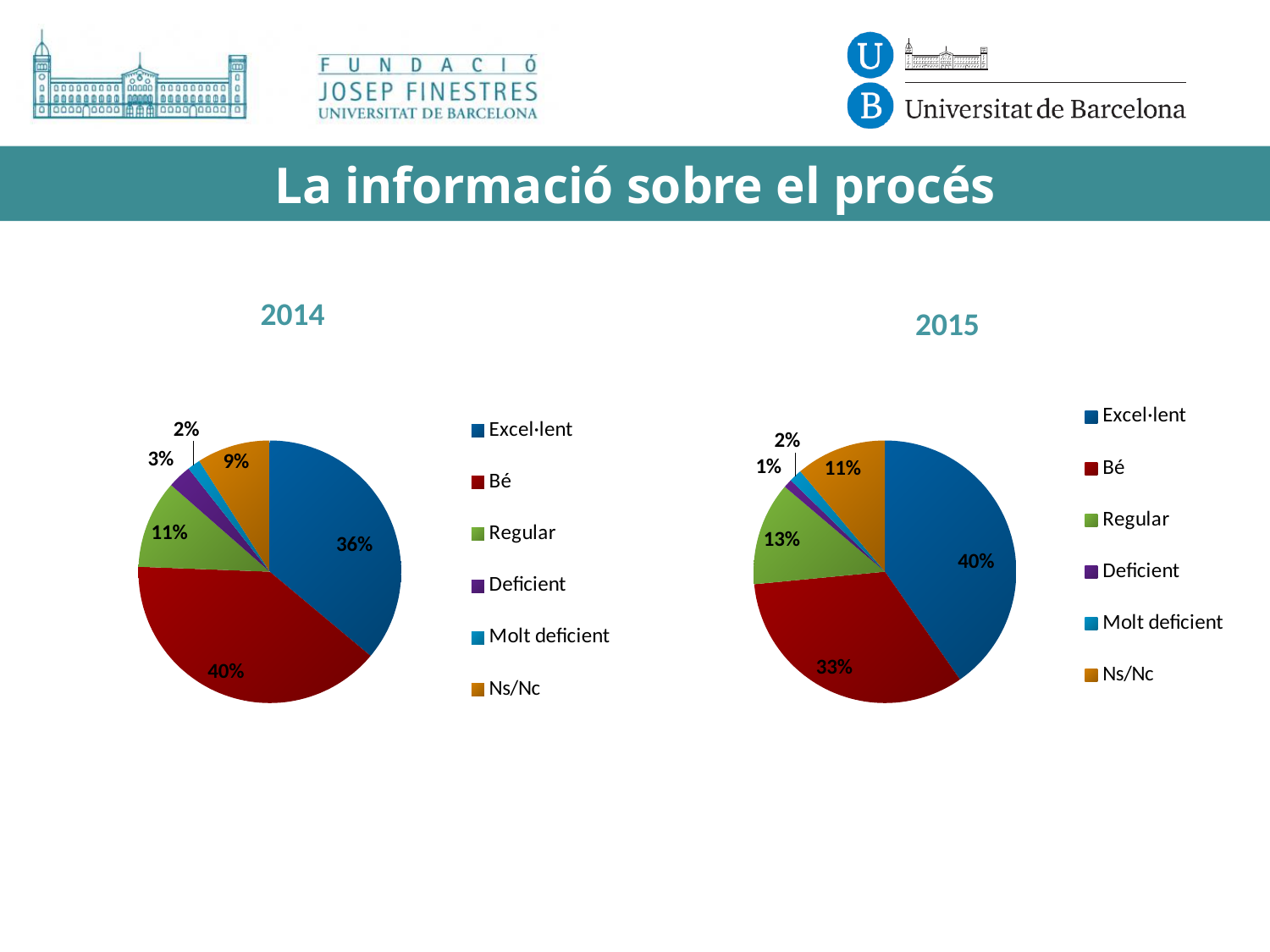
In the 2014 pie chart, what percentage is labelled for Bé? 40% What is the title of the chart on the right side of the slide? 2015 In the 2015 pie chart, what is the difference between the Excel·lent and Bé percentages? 7% In the 2014 pie chart, which is larger, the Regular slice or the Ns/Nc slice? Regular In the 2014 pie chart, what percentage is labelled for Ns/Nc? 9% In the 2014 pie chart, what percentage is labelled for Deficient? 3% How many categories does the legend of the 2015 pie chart list? 6 In the 2015 pie chart, what percentage is labelled for Excel·lent? 40% What kind of chart is used for the 2014 data? Pie chart In the 2014 pie chart, which category has the largest slice? Bé In the 2015 pie chart, what percentage is labelled for Regular? 13% In the 2015 pie chart, which category has the smallest slice? Deficient